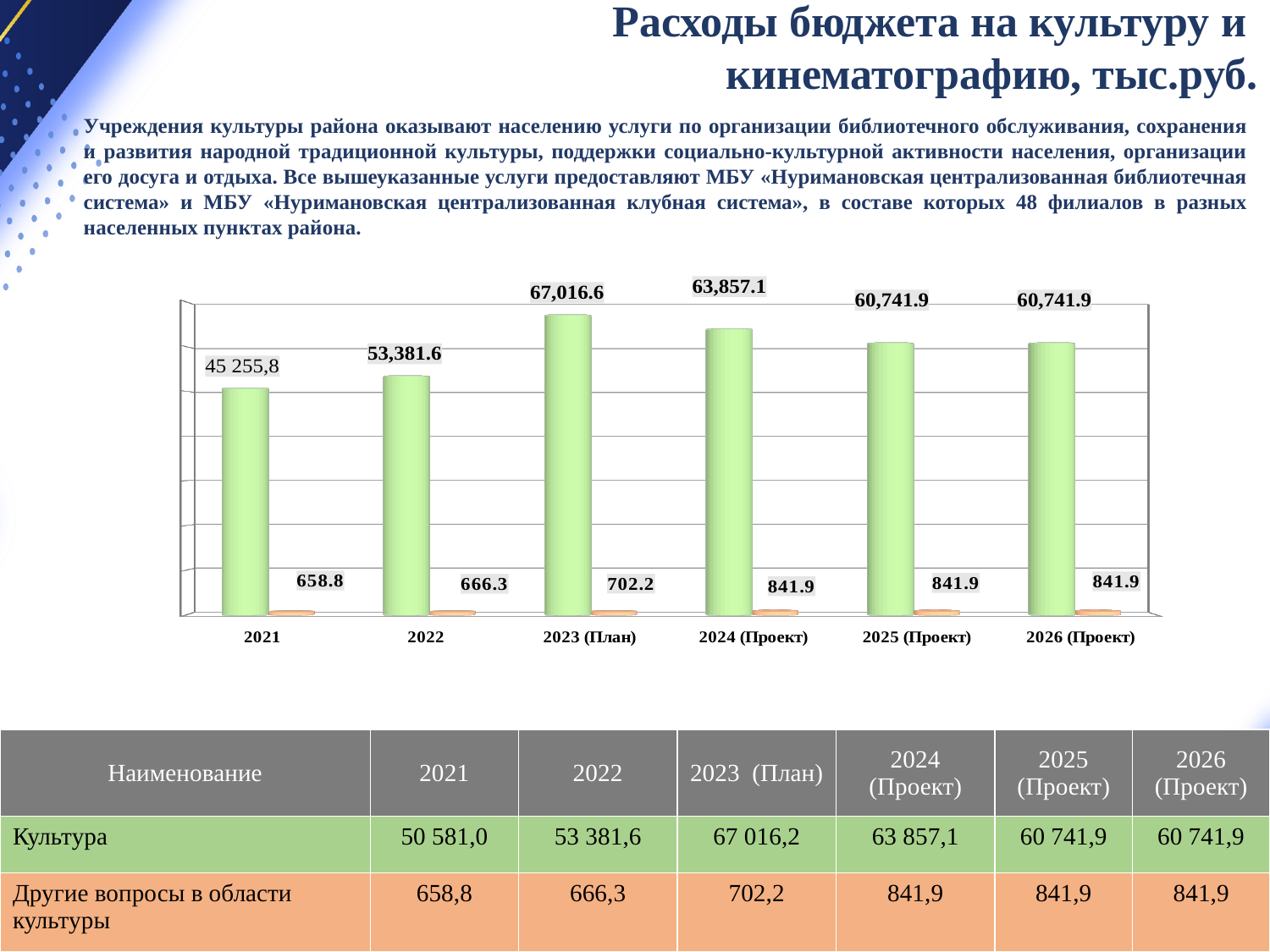
Which is larger, the green bar value for 2022 or for 2021? 2022 What is the title of the slide containing the chart? Расходы бюджета на культуру и кинематографию, тыс.руб. What is the value labelled on the tall green bar for 2023 (План)? 67,016.6 What type of chart is shown on the slide? bar chart What is the value labelled on the tall green bar for 2021? 45 255,8 How many categories are shown along the x axis of the chart? 6 What is the value labelled on the small orange bar for 2022? 666.3 What is the difference between the green bar values for 2023 (План) and 2024 (Проект)? 3,159.5 Which category has the highest value among the tall green bars? 2023 (План) Which category has the lowest value among the tall green bars? 2021 Do the green bar values rise or fall from 2021 to 2023 (План)? rise What is the value labelled on the small orange bar for 2025 (Проект)? 841.9